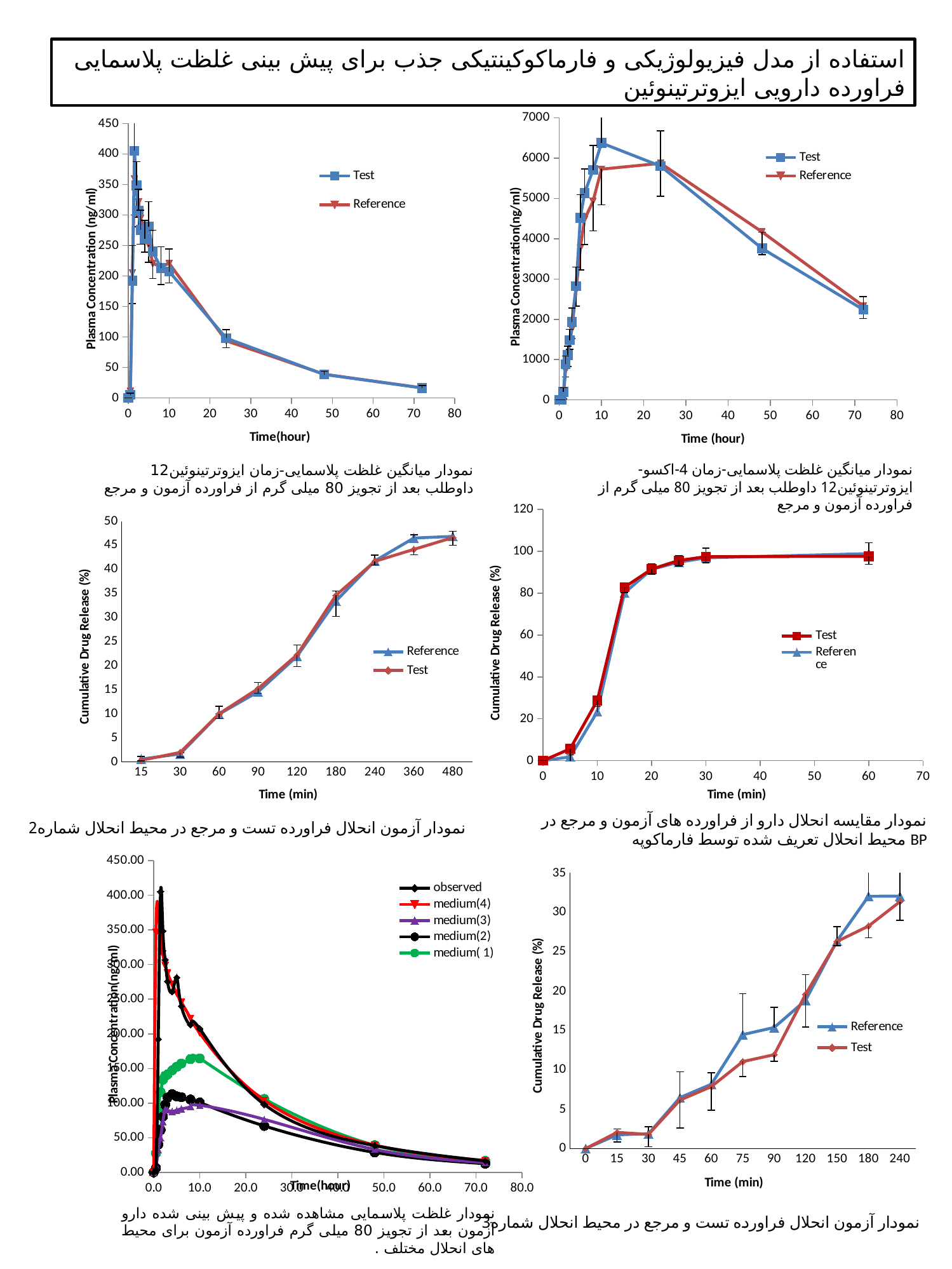
What is the x-axis title of the top-left chart (Plasma Concentration, Test and Reference)? Time(hour) In the top-right chart (Plasma Concentration vs Time (hour), y axis up to 7000), do the Reference values rise or fall from 24 hours to 72 hours? fall In the middle-right chart (Cumulative Drug Release vs Time (min), y axis up to 120), is the Test value at 20 min greater or less than 80? greater In the top-right chart (Plasma Concentration vs Time (hour), y axis up to 7000), is the Test value at 10 hours greater or less than 6000? greater In the bottom-left chart (Plasma Concentration vs Time(hour) with medium series), how many series does the legend list? 5 In the bottom-right chart (Cumulative Drug Release vs Time (min), y axis up to 35), how many time points are shown on the x axis? 11 In the middle-left chart (Cumulative Drug Release vs Time (min), y axis up to 50), do the Test values rise or fall from 15 min to 480 min? rise In the bottom-right chart (Cumulative Drug Release vs Time (min), y axis up to 35), is the Reference value at 180 min greater or less than 30? greater In the middle-left chart (Cumulative Drug Release vs Time (min), y axis up to 50), how many time points are shown on the x axis? 9 What kind of chart is the top-left chart (Plasma Concentration vs Time(hour), Test and Reference)? line chart